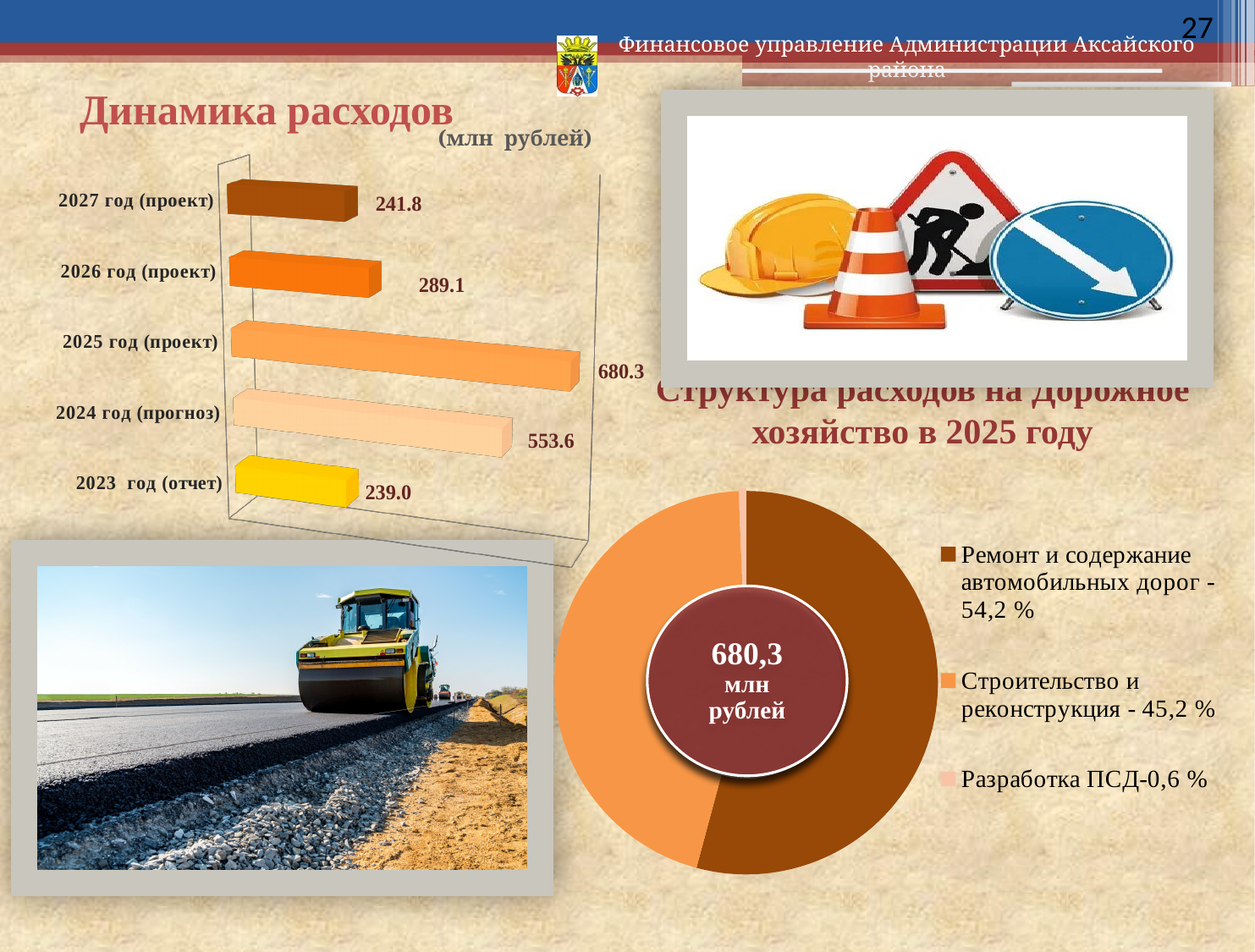
On the 'Динамика расходов' chart, which is larger: the value for 2026 год (проект) or 2027 год (проект)? 2026 год (проект) On the 'Динамика расходов' chart, which year has the highest value? 2025 год (проект) On the 'Динамика расходов' chart, what is the difference between the values for 2025 год (проект) and 2024 год (прогноз)? 126.7 On the 'Структура расходов на дорожное хозяйство в 2025 году' chart, what share does 'Строительство и реконструкция' have? 45,2 % What kind of chart is 'Динамика расходов'? Bar chart How many categories are shown on the 'Динамика расходов' chart? 5 On the 'Динамика расходов' chart, what is the value for 2023 год (отчет)? 239.0 On the 'Динамика расходов' chart, which year has the lowest value? 2023 год (отчет) What total amount is shown in the centre of the 'Структура расходов на дорожное хозяйство в 2025 году' chart? 680,3 млн рублей On the 'Динамика расходов' chart, what is the value for 2027 год (проект)? 241.8 On the 'Динамика расходов' chart, what is the value for 2025 год (проект)? 680.3 On the 'Структура расходов на дорожное хозяйство в 2025 году' chart, which category has the largest share? Ремонт и содержание автомобильных дорог